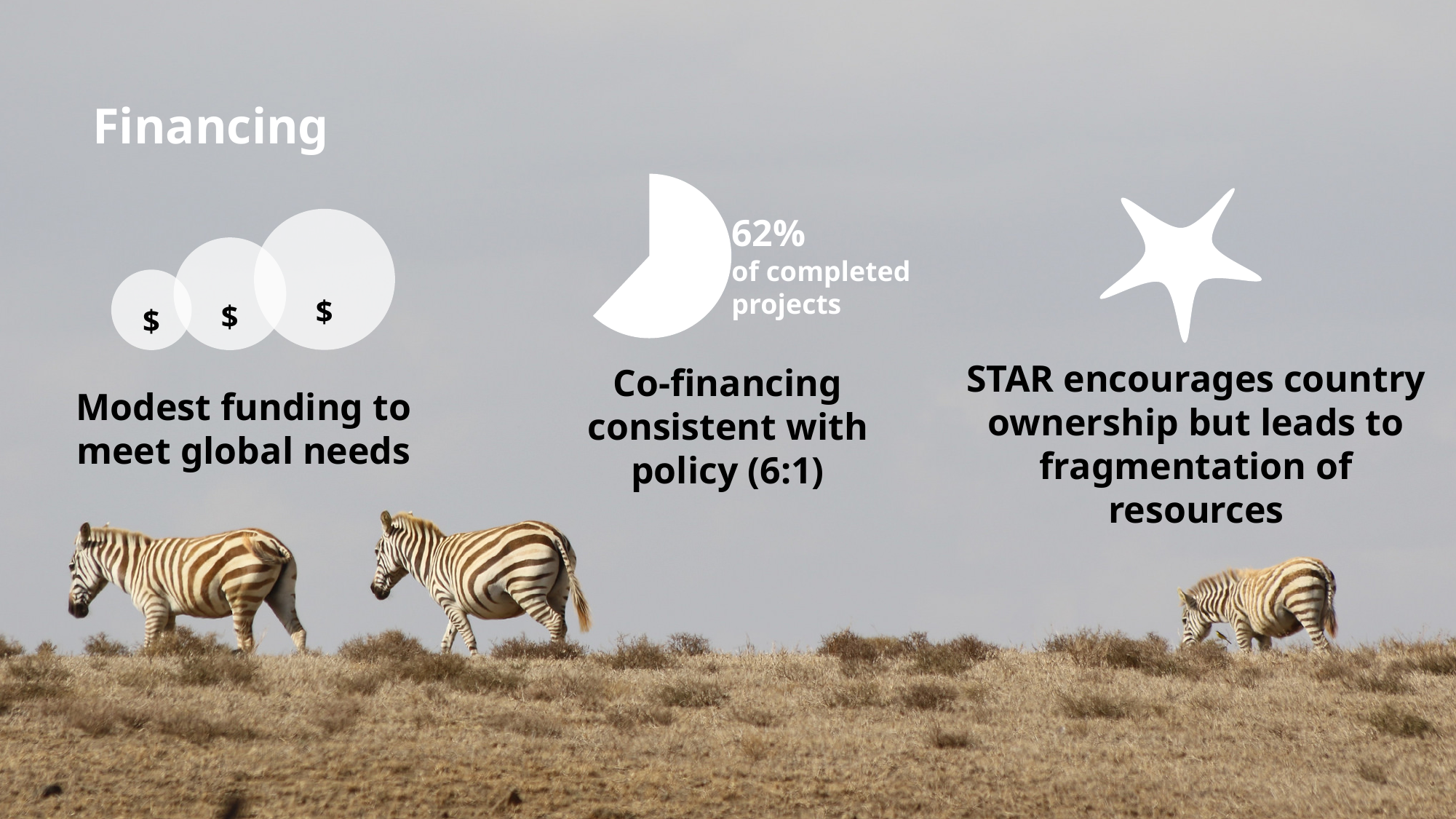
What kind of chart is shown in the middle of the slide next to the '62%' label? pie chart In the pie chart in the middle of the slide, what share of completed projects does the highlighted slice represent? 62% What percentage value is printed next to the pie chart in the middle of the slide? 62% What is the title of the slide containing the pie chart? Financing According to the label next to the pie chart, what does the 62% refer to? of completed projects How many slices are visibly drawn in the pie chart in the middle of the slide? 1